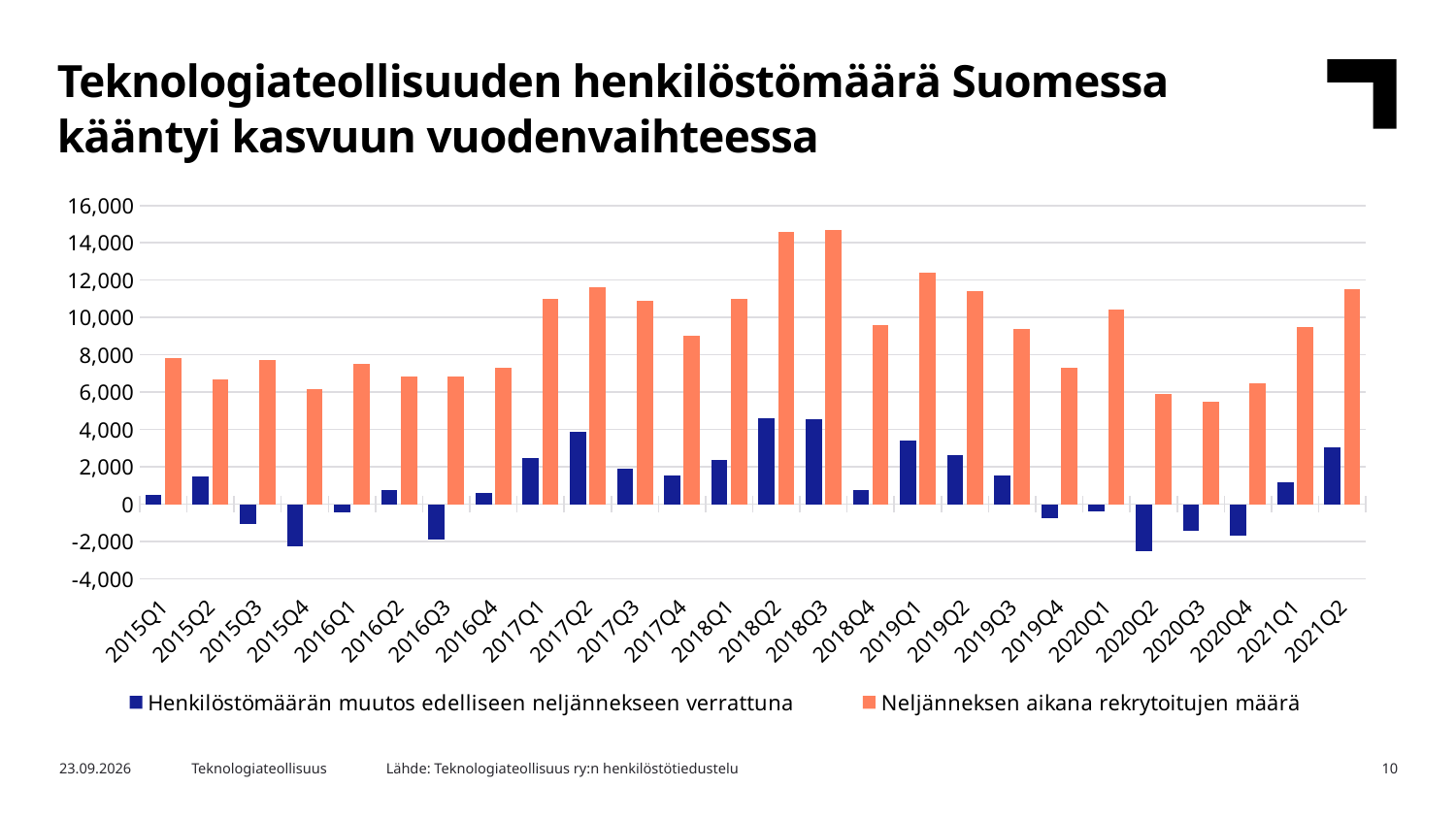
What kind of chart is shown on the slide? Bar chart Is the value for 'Henkilöstömäärän muutos edelliseen neljännekseen verrattuna' in 2020Q2 greater or less than -2,000? less Is the value for 'Henkilöstömäärän muutos edelliseen neljännekseen verrattuna' in 2018Q2 greater or less than 4,000? greater Which quarter has the larger value for 'Neljänneksen aikana rekrytoitujen määrä', 2019Q1 or 2019Q2? 2019Q1 Is the value for 'Neljänneksen aikana rekrytoitujen määrä' in 2020Q3 greater or less than 6,000? less How many quarters are shown on the x axis? 26 Do the values for 'Neljänneksen aikana rekrytoitujen määrä' rise or fall from 2020Q3 to 2021Q2? rise Which quarter has the larger value for 'Henkilöstömäärän muutos edelliseen neljännekseen verrattuna', 2021Q1 or 2021Q2? 2021Q2 How many series does the legend list? 2 What colour represents 'Neljänneksen aikana rekrytoitujen määrä' in the chart? Orange Which quarter has the lowest value for 'Neljänneksen aikana rekrytoitujen määrä'? 2020Q3